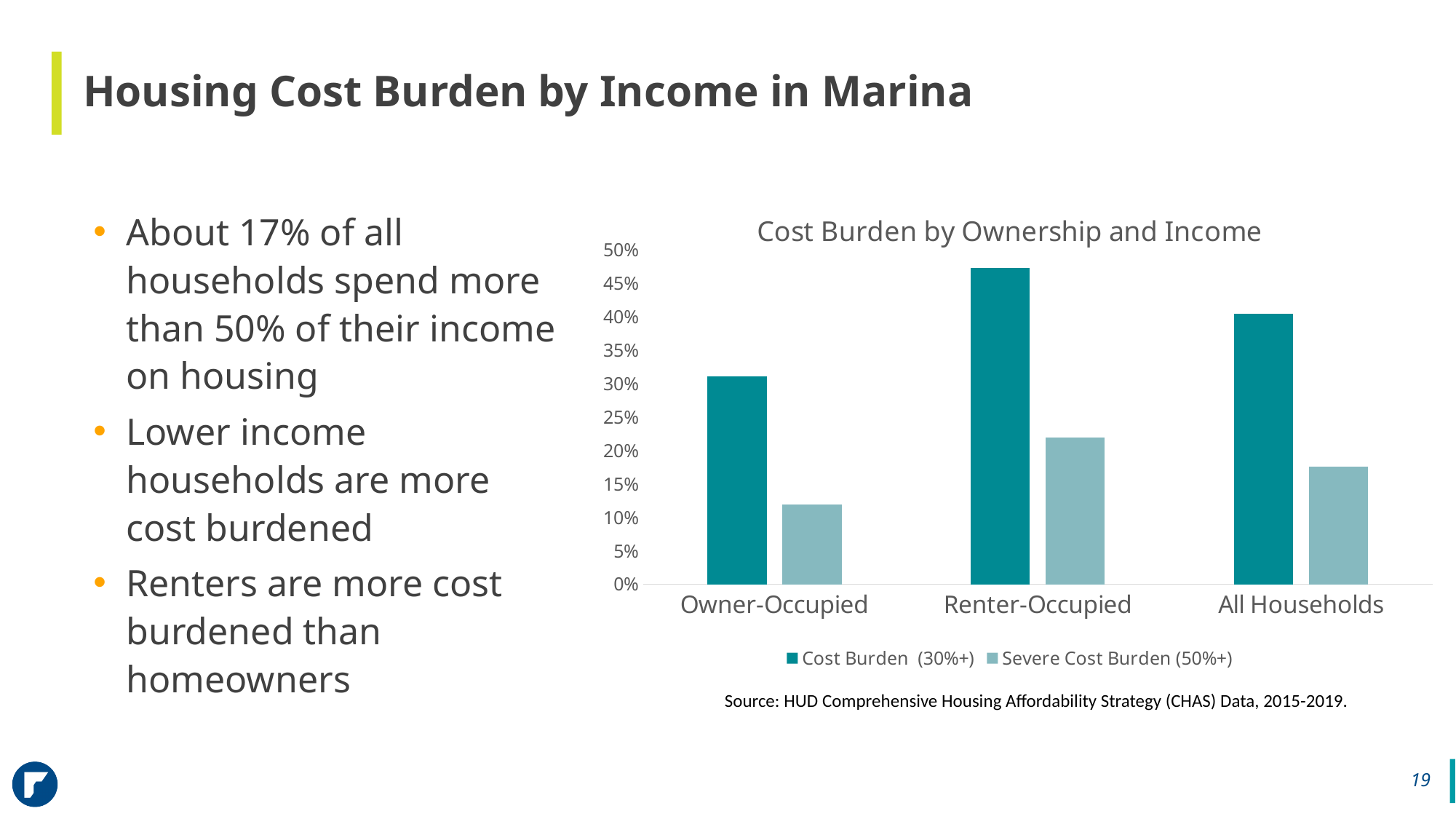
Is the Severe Cost Burden (50%+) value for Owner-Occupied greater or less than 15%? less Which is larger: the Cost Burden (30%+) value for Renter-Occupied or for Owner-Occupied? Renter-Occupied Is the Cost Burden (30%+) value for Renter-Occupied greater or less than 45%? greater Which category has the lowest Cost Burden (30%+) value? Owner-Occupied Which category has the lowest Severe Cost Burden (50%+) value? Owner-Occupied What is the title of the chart? Cost Burden by Ownership and Income How many categories are shown on the x axis of the chart? 3 Is the Severe Cost Burden (50%+) value for All Households greater or less than 20%? less Which category has the highest Cost Burden (30%+) value? Renter-Occupied What kind of chart is shown on the slide? Bar chart How many series does the legend of the chart list? 2